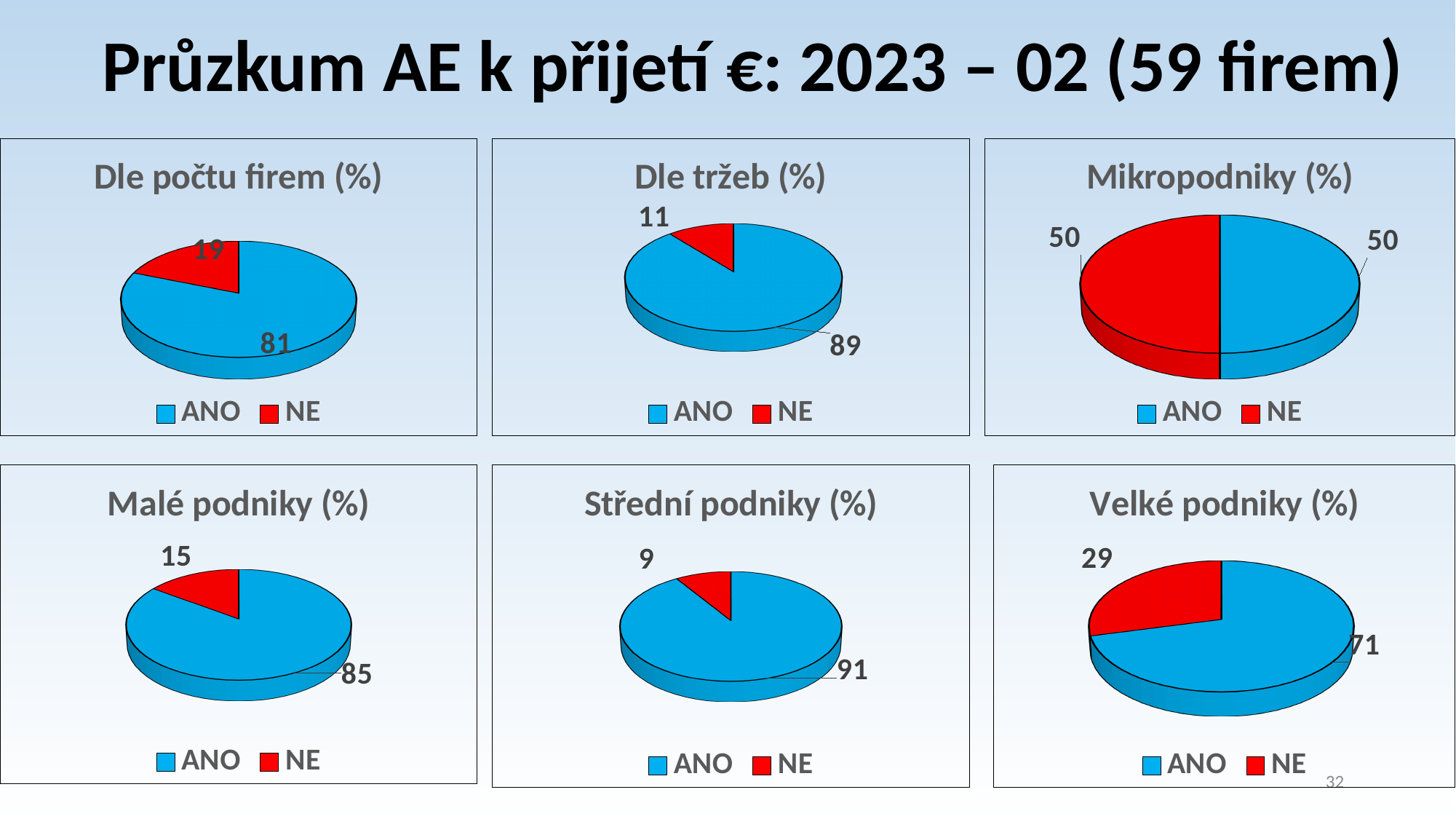
In the 'Dle tržeb (%)' chart, which colour represents NE? Red In the 'Dle počtu firem (%)' chart, what is the value for ANO? 81 In the 'Střední podniky (%)' chart, what is the value for ANO? 91 How many series does the legend of the 'Malé podniky (%)' chart list? 2 In the 'Mikropodniky (%)' chart, what is the value for ANO? 50 In the 'Dle tržeb (%)' chart, what is the value for NE? 11 How many slices does the 'Mikropodniky (%)' pie chart have? 2 What kind of chart is 'Střední podniky (%)'? Pie chart In the 'Dle počtu firem (%)' chart, what is the difference between the ANO and NE values? 62 In the 'Velké podniky (%)' chart, which slice is larger, ANO or NE? ANO In the 'Malé podniky (%)' chart, what is the value for NE? 15 In the 'Velké podniky (%)' chart, what is the value for NE? 29